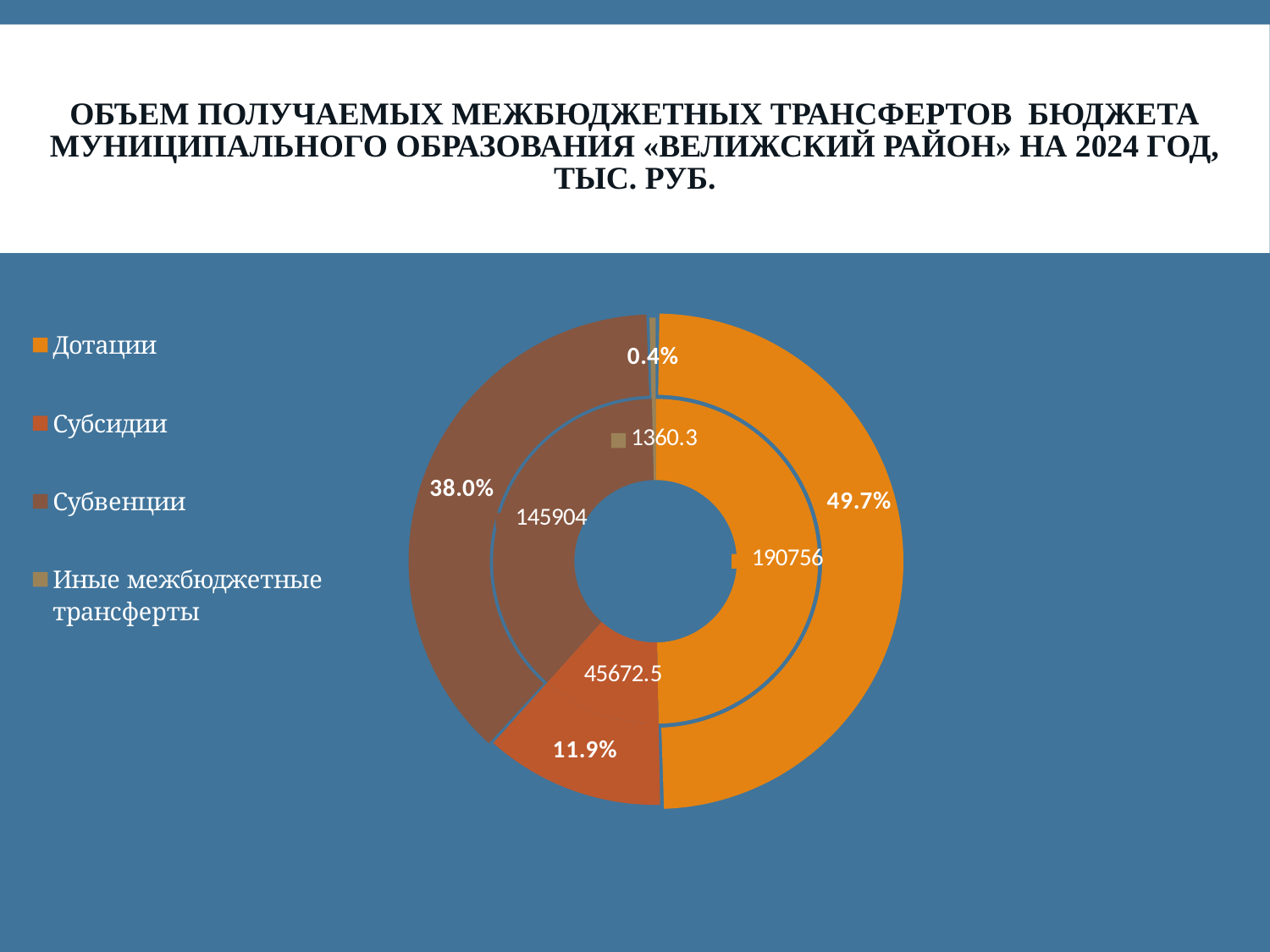
What percentage share is shown for Дотации on the outer ring? 49.7% What is the value for Субвенции shown on the inner ring? 145904 What is the difference between the values for Дотации and Субвенции? 44852 Which category has the largest share? Дотации Which is larger, the value for Субсидии or the value for Субвенции? Субвенции What is the value for Иные межбюджетные трансферты shown on the inner ring? 1360.3 How many categories does the legend list? 4 Which category has the smallest share? Иные межбюджетные трансферты What is the value for Дотации shown on the inner ring? 190756 What percentage share is shown for Субвенции on the outer ring? 38.0% What type of chart is shown on the slide? Doughnut chart What is the value for Субсидии shown on the inner ring? 45672.5